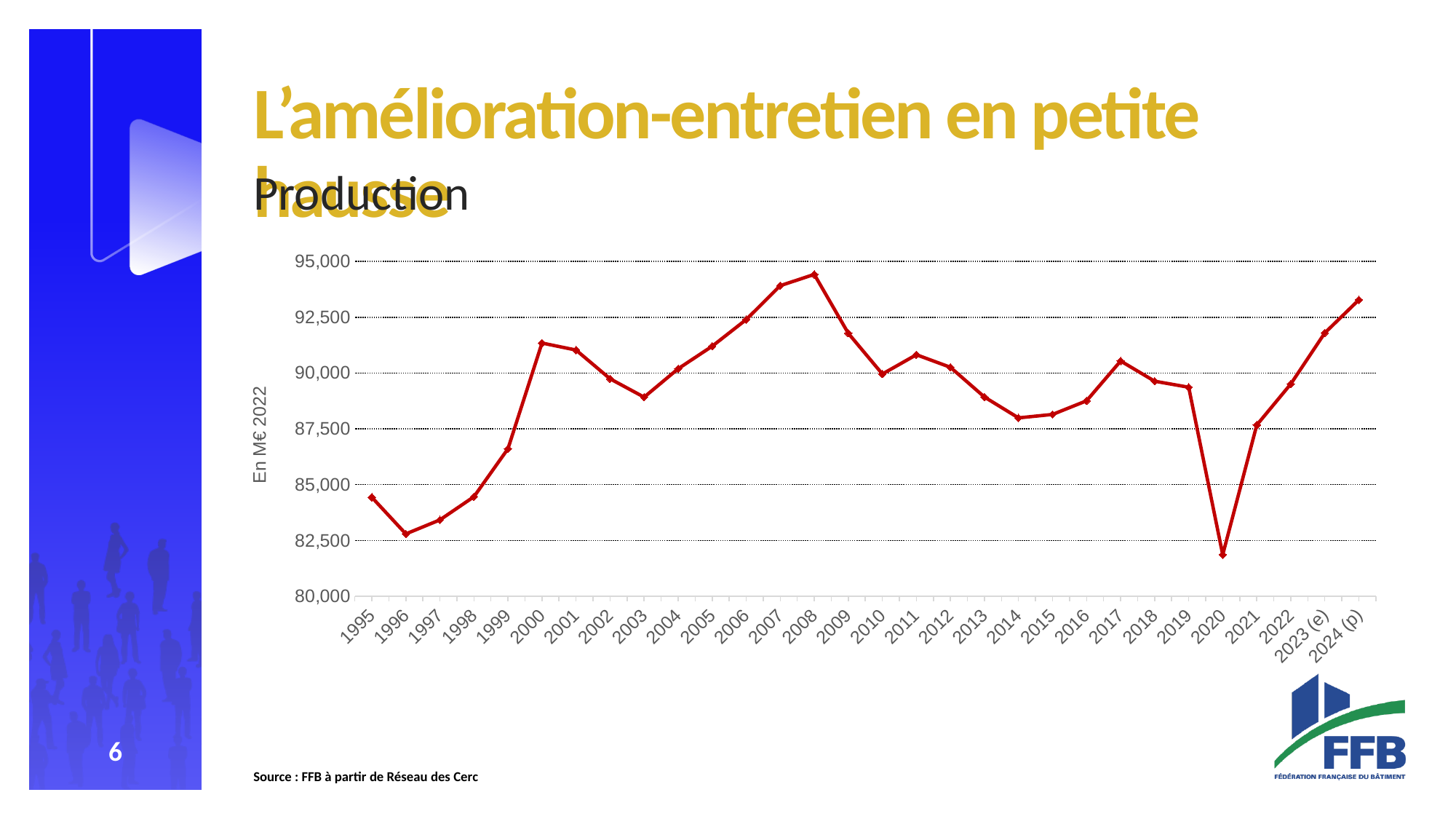
Which year has the higher value, 2000 or 2003? 2000 How many years are plotted on the x axis of the Production chart? 30 What kind of chart is shown on the slide? line chart What is the label of the vertical axis of the chart? En M€ 2022 Is the value for 2008 greater or less than 92,500? greater Does the value rise or fall from 2020 to 2024 (p)? rise Is the value for 1995 greater or less than 85,000? less In which year does the Production chart reach its highest value? 2008 Is the value for 2003 greater or less than 90,000? less In which year does the Production chart reach its lowest value? 2020